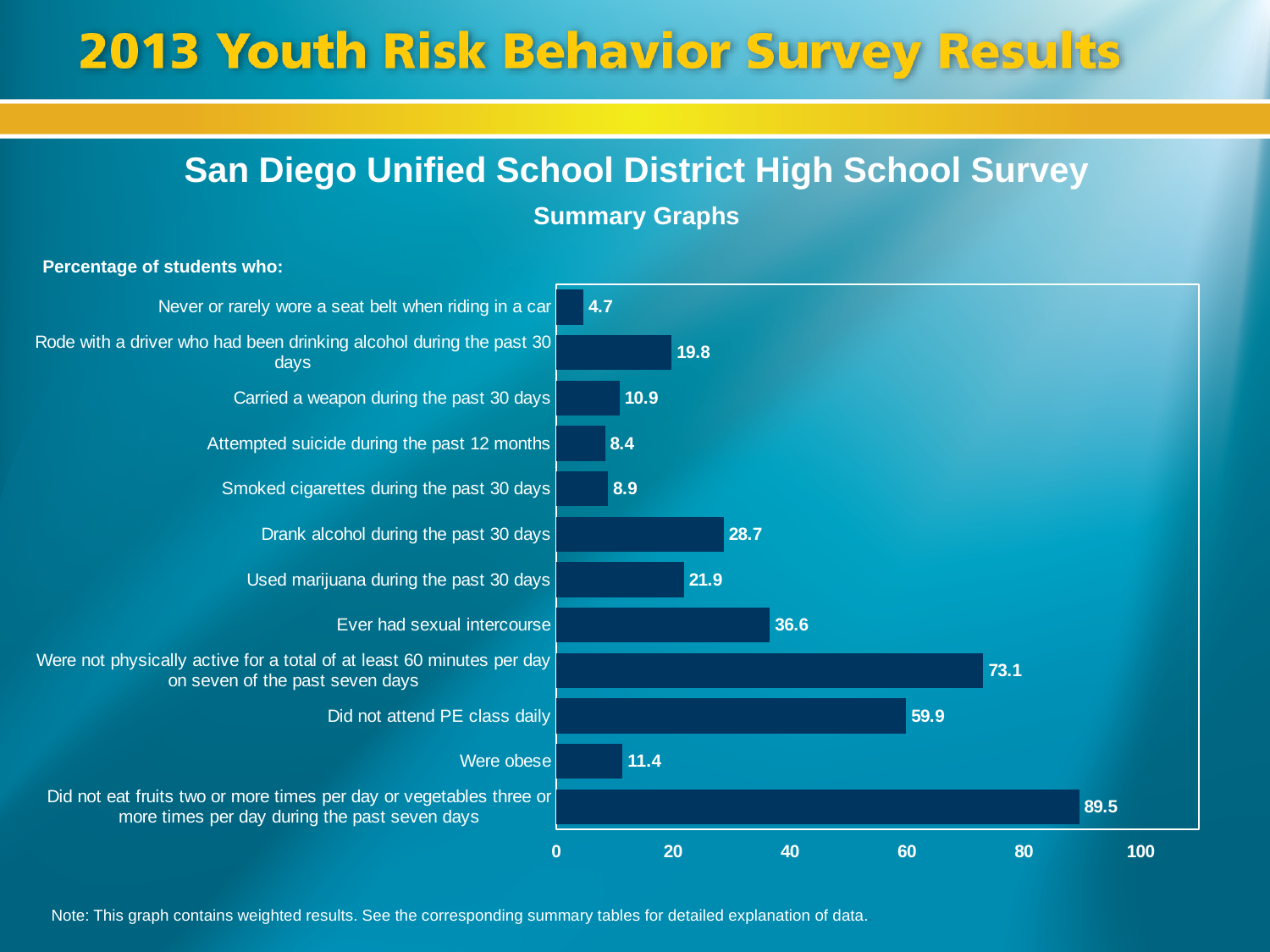
Is the value for 'Ever had sexual intercourse' greater or less than 40? less What is the maximum value shown on the horizontal axis? 100 Which is larger: the percentage who used marijuana during the past 30 days or the percentage who drank alcohol during the past 30 days? Drank alcohol during the past 30 days What is the difference between the percentage who rode with a driver who had been drinking alcohol and the percentage who carried a weapon during the past 30 days? 8.9 Which category has the lowest percentage? Never or rarely wore a seat belt when riding in a car What percentage of students drank alcohol during the past 30 days? 28.7 What percentage of students never or rarely wore a seat belt when riding in a car? 4.7 What percentage of students were obese? 11.4 How many categories are shown in the chart? 12 What kind of chart is shown on the slide? Bar chart What is the difference between the percentage who did not attend PE class daily and the percentage who were obese? 48.5 Which category has the highest percentage? Did not eat fruits two or more times per day or vegetables three or more times per day during the past seven days